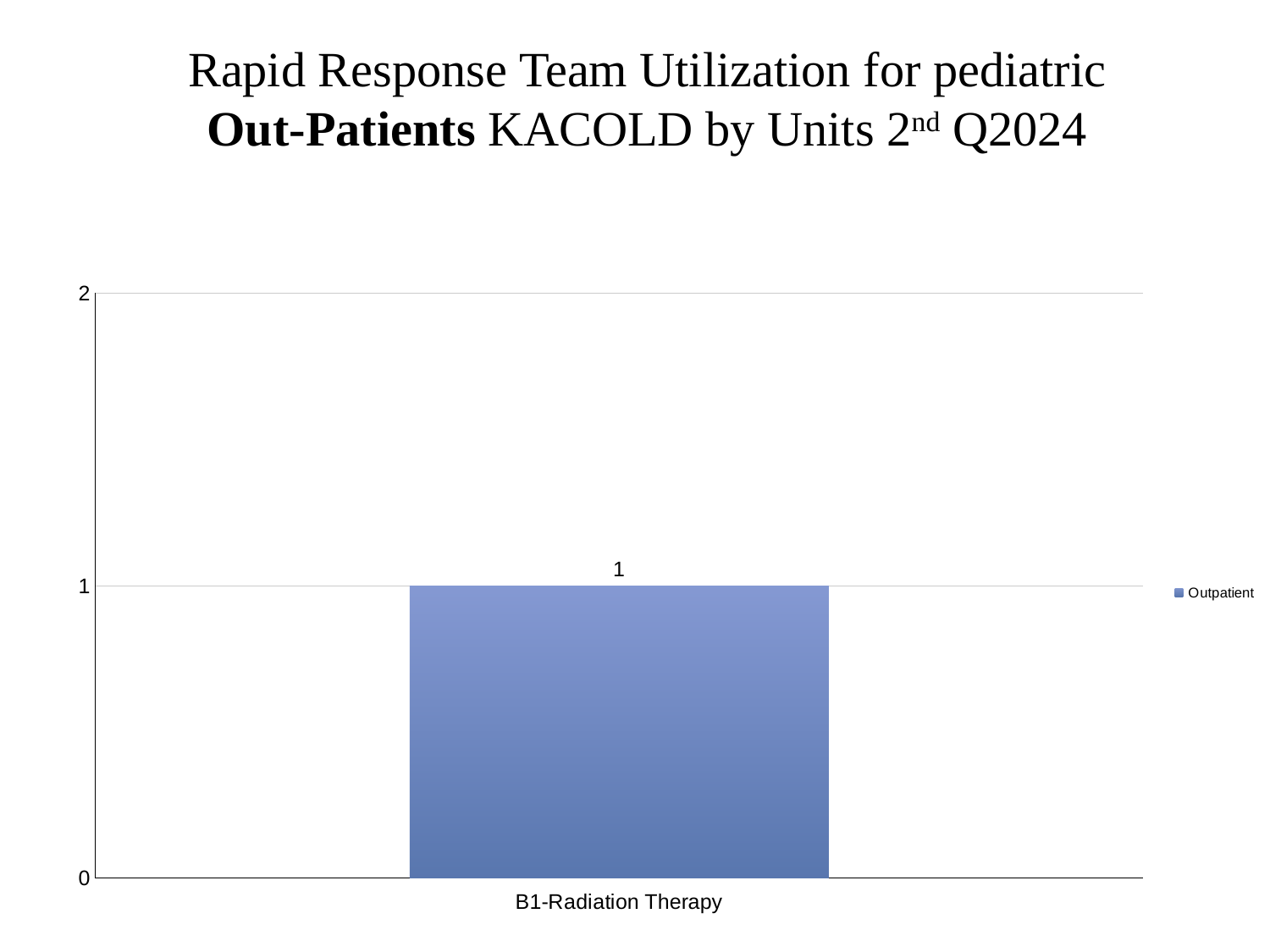
What is the name of the series listed in the legend? Outpatient Is the value for B1-Radiation Therapy greater or less than 2? less How many categories are shown on the x axis of the chart? 1 What is the highest value shown on the vertical axis? 2 What is the value for B1-Radiation Therapy? 1 What kind of chart is shown on the slide? bar chart What is the label of the only category on the x axis? B1-Radiation Therapy How many series does the legend list? 1